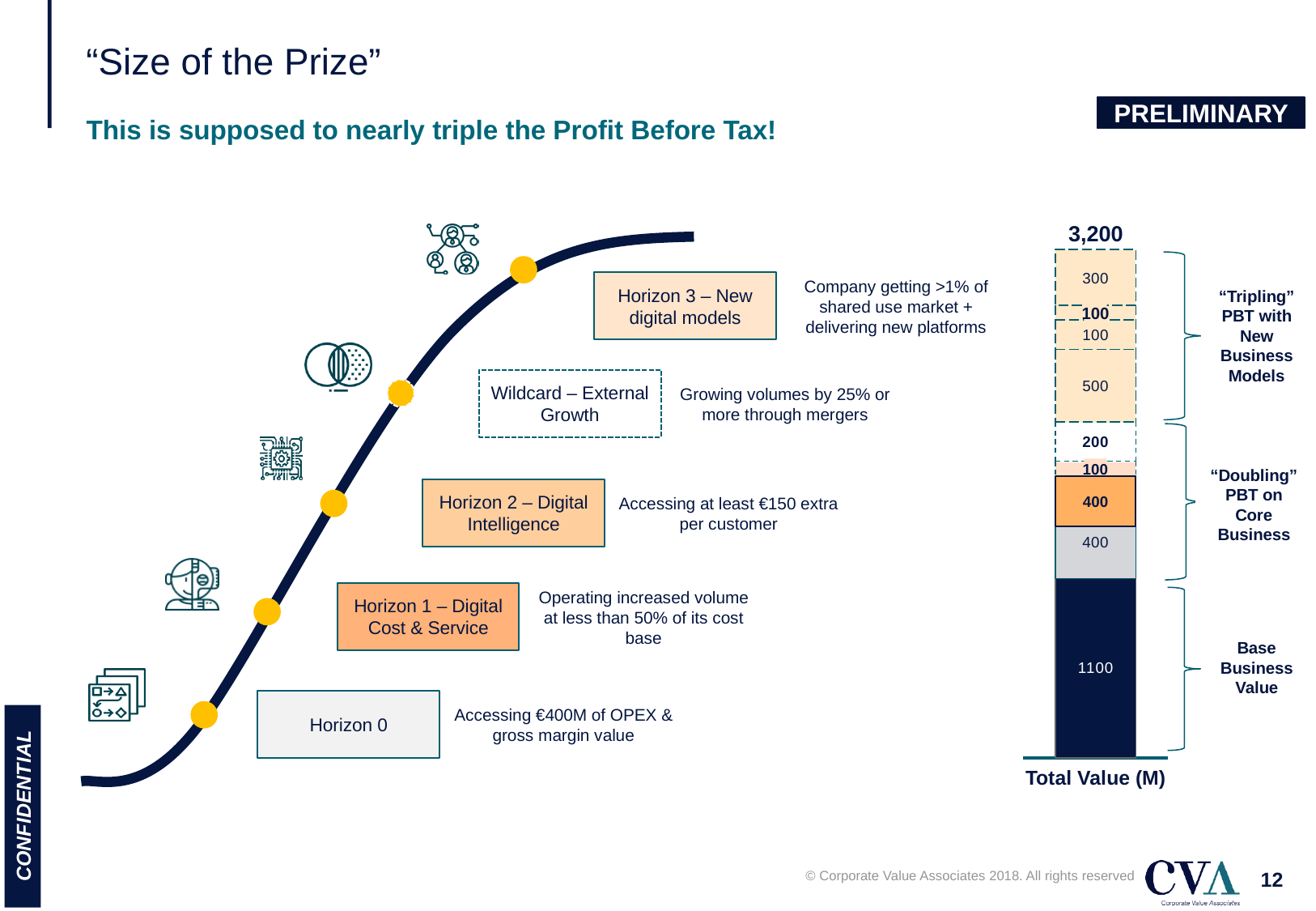
What is the combined value of the segments in the "Doubling" PBT on Core Business group (200, 100, 400, 400)? 1100 What is the value of the topmost segment of the stacked bar? 300 Which is larger: the Base Business Value segment or the topmost 300 segment? Base Business Value segment What is the axis label printed below the stacked bar? Total Value (M) What kind of chart is shown on the right of the slide? Stacked bar chart What is the difference between the Base Business Value segment (1100) and the 500 segment in the New Business Models group? 600 What is the total value shown at the top of the stacked bar? 3,200 How many segments make up the stacked bar? 9 What is the value of the largest single segment in the stacked bar? 1100 What is the value of the Base Business Value segment at the bottom of the stacked bar? 1100 What is the value of the largest segment within the "Tripling" PBT with New Business Models group? 500 What is the combined value of the segments in the "Tripling" PBT with New Business Models group (300, 100, 100, 500)? 1000